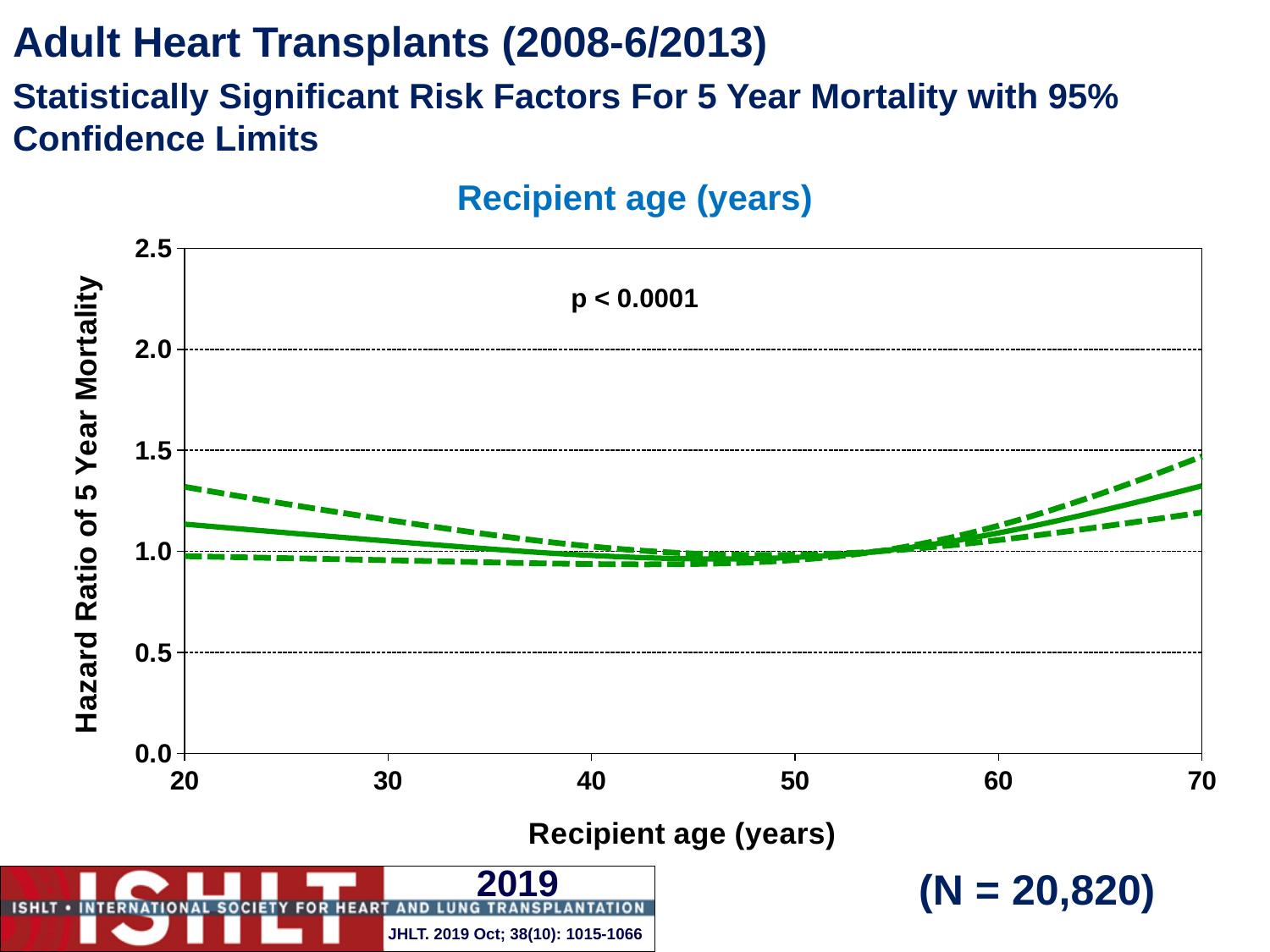
How many lines are plotted on the chart? 3 What is the highest value shown on the y axis of the chart? 2.5 Is the hazard ratio shown by the solid line at recipient age 20 greater or less than 1.0? greater Does the hazard ratio shown by the solid line rise or fall as recipient age increases from 50 to 70? rise What kind of chart is shown on the slide? line chart Is the hazard ratio shown by the solid line at recipient age 70 greater or less than 1.5? less What p-value is printed on the chart? p < 0.0001 Does the hazard ratio shown by the solid line rise or fall as recipient age increases from 20 to 40? fall Is the hazard ratio shown by the solid line at recipient age 20 greater or less than 1.5? less Which has the larger hazard ratio on the solid line: recipient age 20 or recipient age 70? recipient age 70